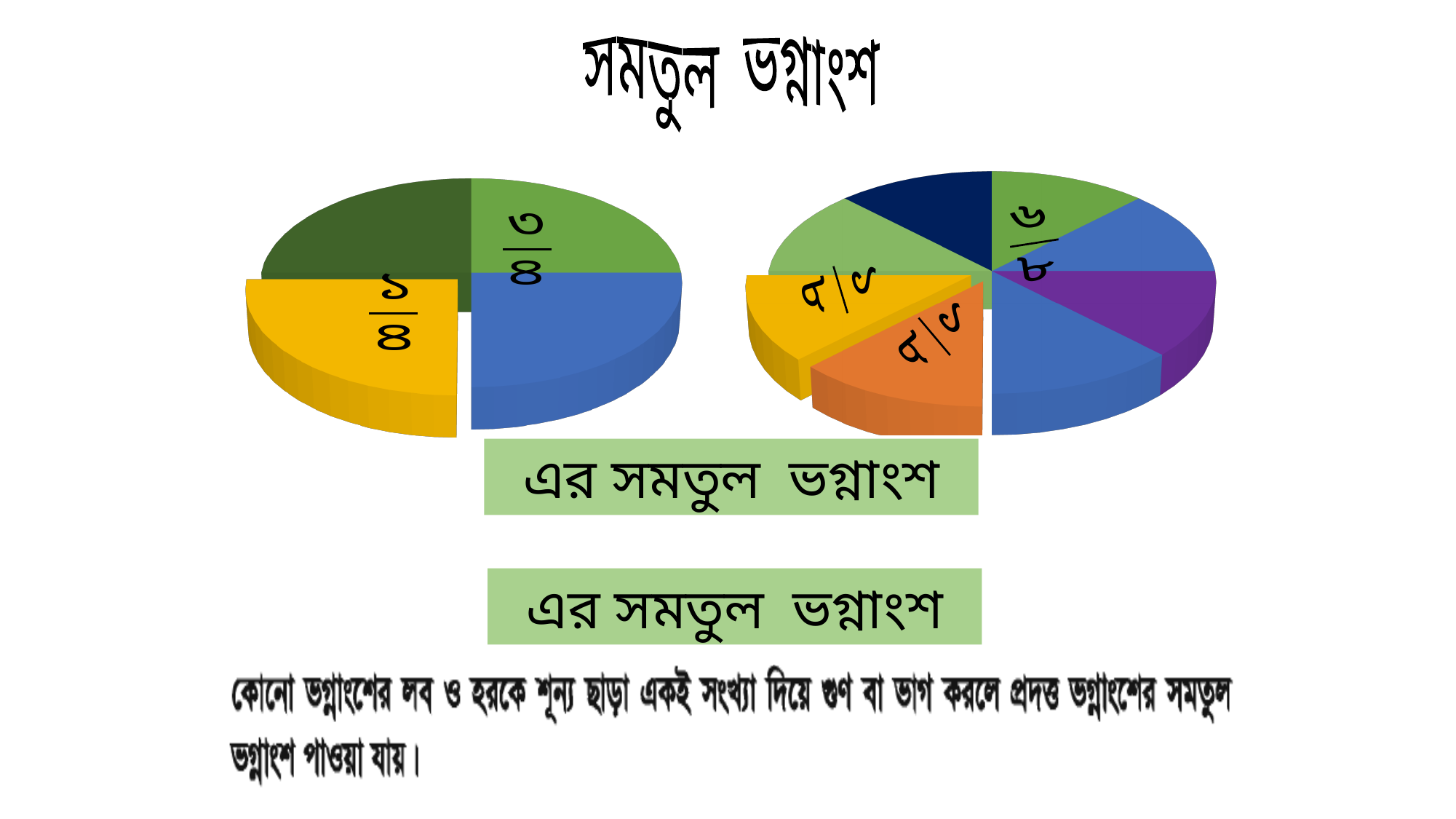
Which chart has more slices, the left pie chart or the right pie chart? the right pie chart What is the title shown at the top of the slide? সমতুল ভগ্নাংশ How many slices does the pie chart on the right have? 8 What kind of chart is the chart on the right of the slide? pie chart What kind of chart is the chart on the left of the slide? pie chart In the pie chart on the left, what fraction label is printed on the green slice? ৩/৪ How many slices does the pie chart on the left have? 4 In the pie chart on the right, what fraction label is printed on the light green slice at the top? ৬/৮ In the pie chart on the left, which slice is pulled out from the rest of the pie? the yellow slice In the pie chart on the left, what fraction label is printed on the yellow slice? ১/৪